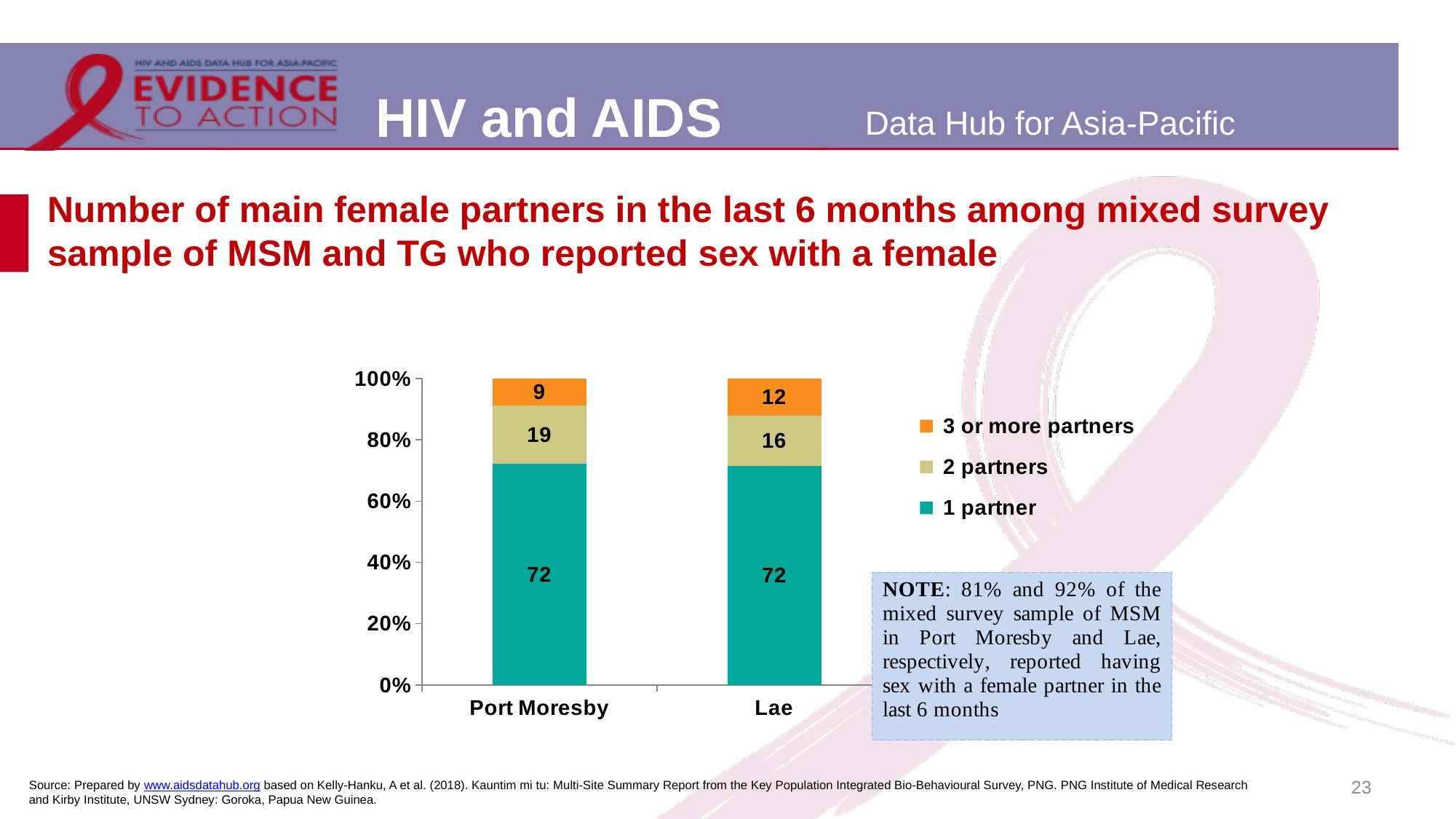
Which series has the lowest value in Port Moresby? 3 or more partners What is the value for '1 partner' in Port Moresby? 72 What is the value for '2 partners' in Lae? 16 Which city has the higher value for '2 partners', Port Moresby or Lae? Port Moresby What is the value for '3 or more partners' in Port Moresby? 9 What is the difference between the '3 or more partners' values for Lae and Port Moresby? 3 What is the total of the stacked bar for Lae? 100 How many categories are shown on the x axis of the chart? 2 What kind of chart is shown on the slide? Stacked bar chart How many series does the chart's legend list? 3 Which series is shown in orange in the chart's legend? 3 or more partners What is the value for '3 or more partners' in Lae? 12